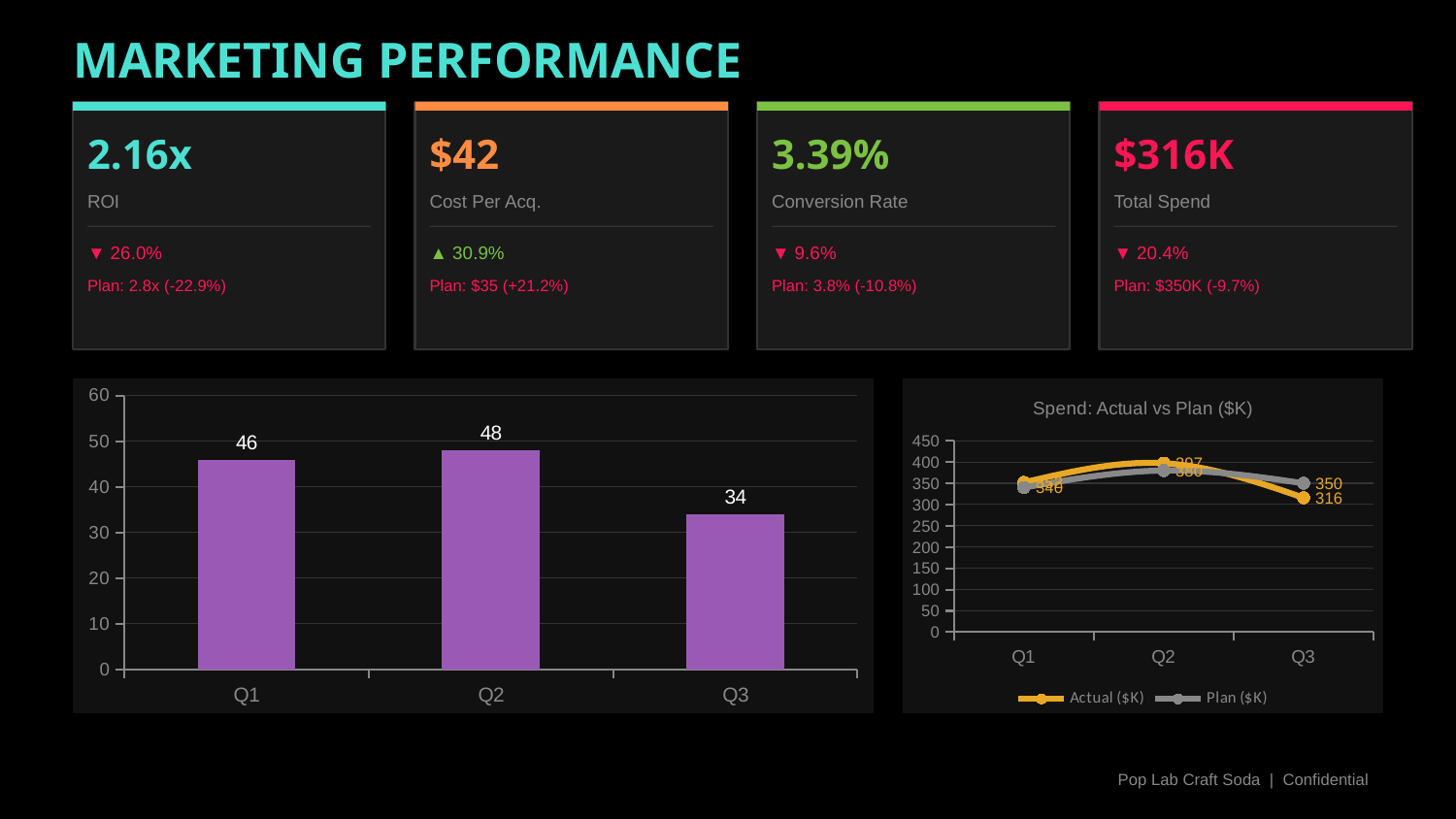
In the 'Spend: Actual vs Plan ($K)' chart, how many series does the legend list? 2 In the 'Spend: Actual vs Plan ($K)' chart, is the Actual ($K) value for Q2 greater or less than 350? greater On the left bar chart, how many categories are shown on the x axis? 3 On the left bar chart, what is the difference between the values for Q1 and Q3? 12 On the left bar chart, which quarter has the lowest value? Q3 In the 'Spend: Actual vs Plan ($K)' chart, what is the Plan ($K) value for Q3? 350 What kind of chart is the chart on the left of the slide? Bar chart On the left bar chart, what is the value for Q2? 48 On the left bar chart, which quarter has the highest value? Q2 On the left bar chart, which is larger, the value for Q1 or the value for Q3? Q1 In the 'Spend: Actual vs Plan ($K)' chart, what is the Actual ($K) value for Q3? 316 On the left bar chart, what is the value for Q3? 34